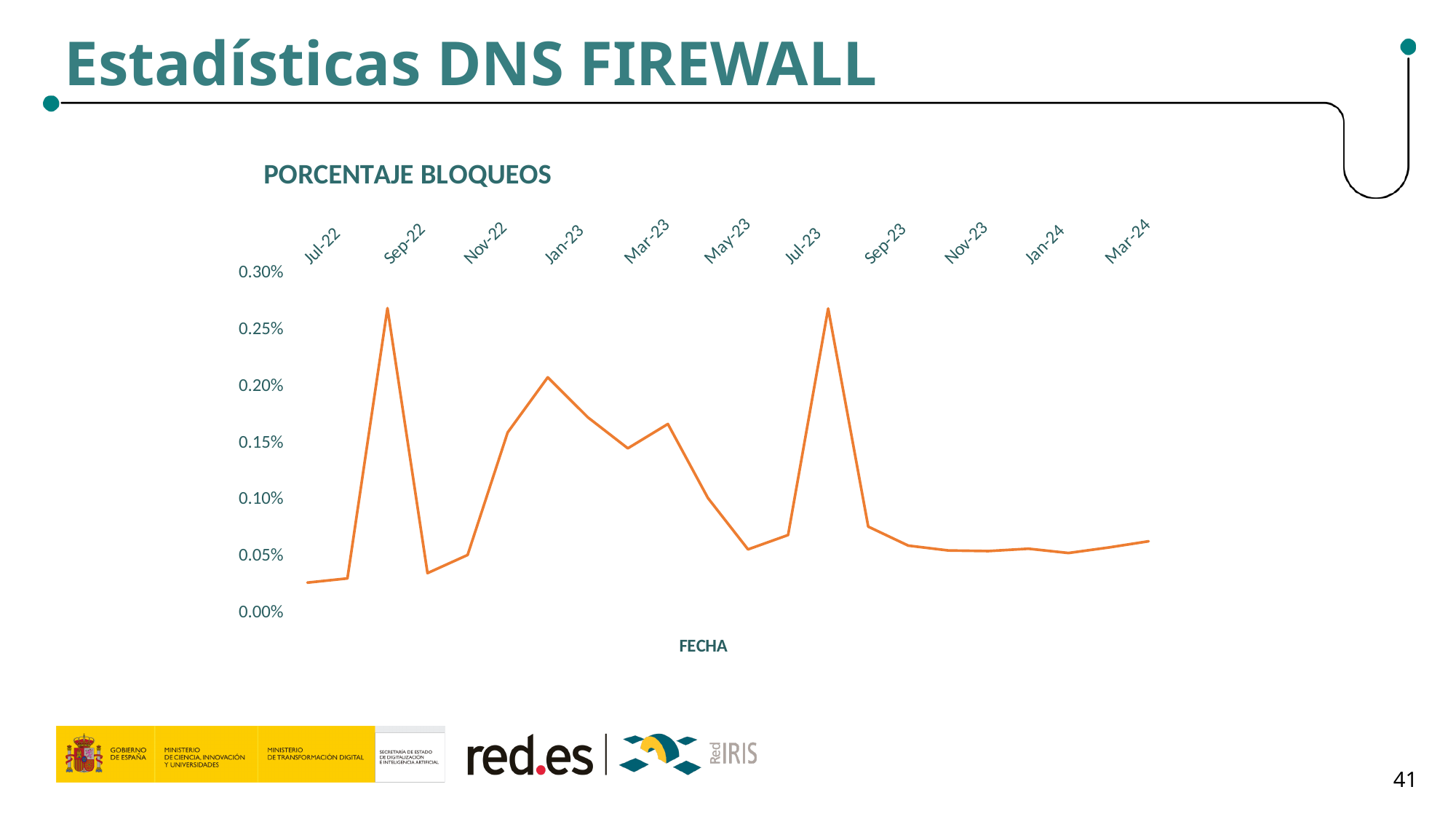
Is the value for Jan-23 greater or less than 0.15%? greater Is the value for Sep-22 greater or less than 0.25%? greater What is the label of the x axis? FECHA Is the value for Jul-23 greater or less than 0.25%? less What kind of chart is shown on the slide? line chart How many date labels are shown on the x axis? 11 Do the values rise or fall from Jul-23 to Nov-23? fall What is the title of the chart? PORCENTAJE BLOQUEOS Which is larger, the value for Sep-22 or the value for Jan-23? Sep-22 Among the months labelled on the x axis, which has the lowest value? Jul-22